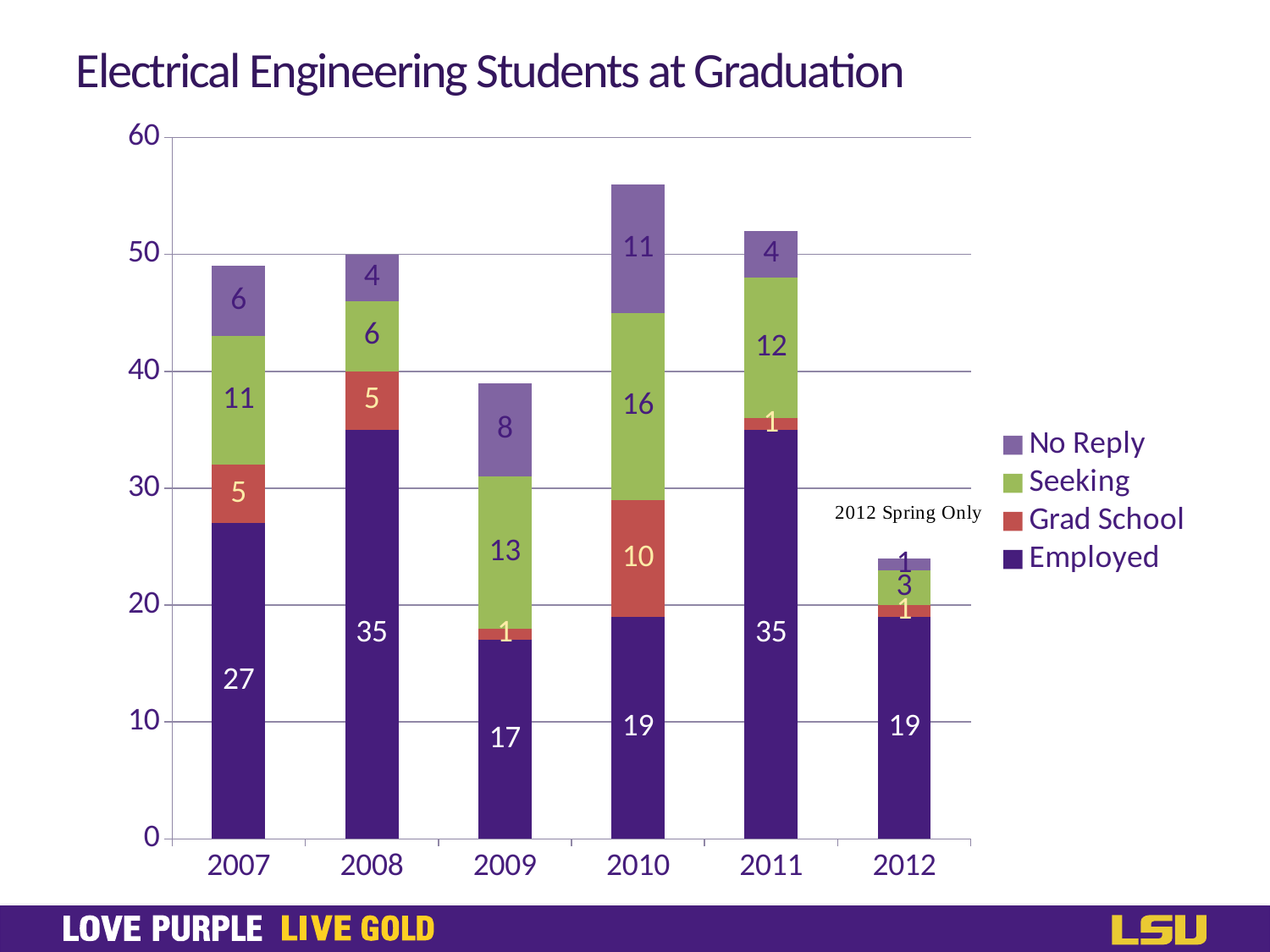
How many series does the legend list? 4 What is the Seeking value for 2010? 16 What is the Grad School value for 2009? 1 Which year has the highest No Reply value? 2010 Which is larger, the Seeking value for 2009 or the Seeking value for 2011? 2009 How many students were Employed at graduation in 2008? 35 How many years are shown on the x axis? 6 What is the difference between the Employed values for 2007 and 2009? 10 What is the total number of students in the 2010 bar? 56 Which year has the lowest Employed value? 2009 What is the total number of students in the 2012 bar? 24 What type of chart is shown on the slide? Stacked bar chart